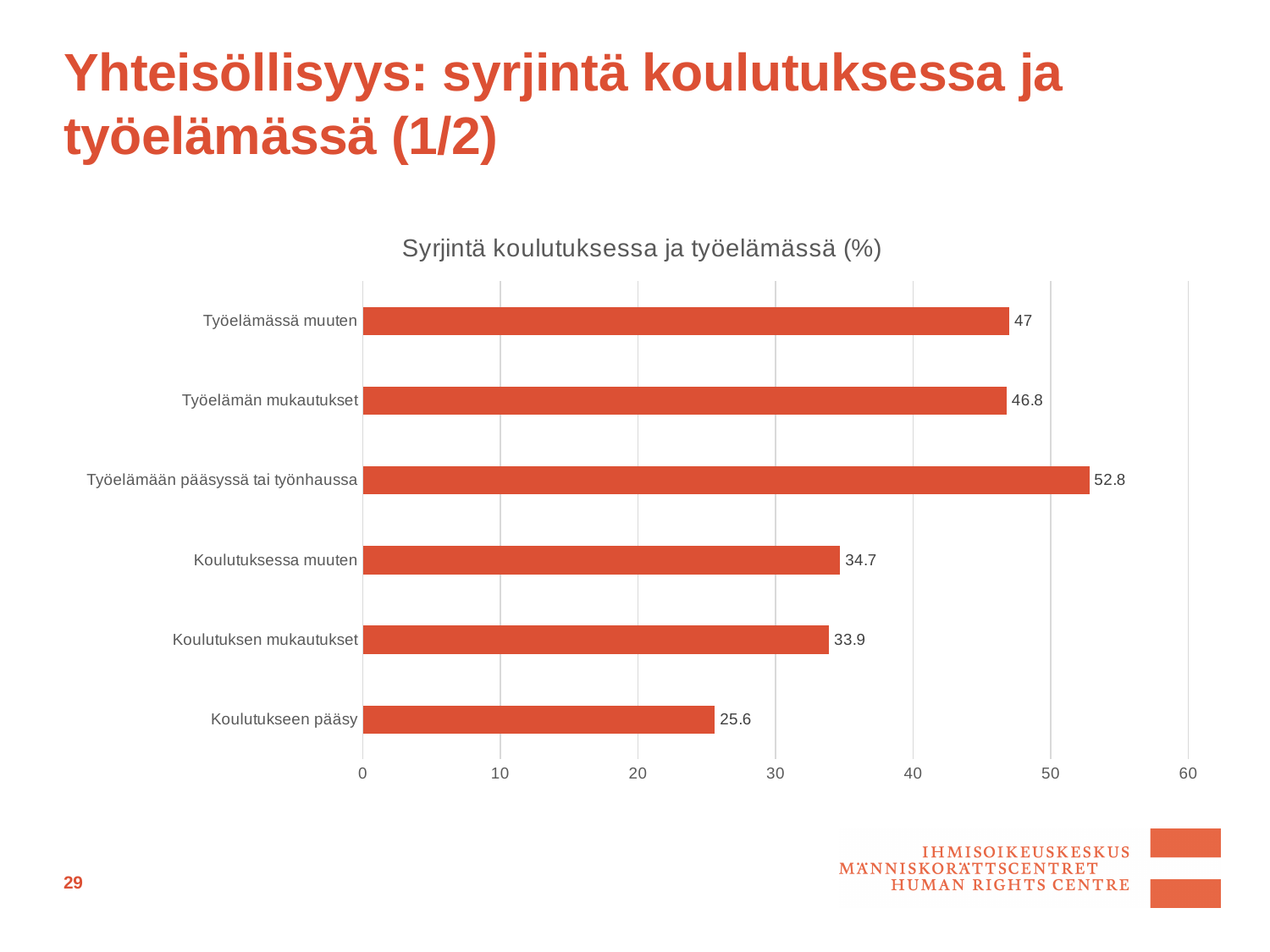
What is the value for Koulutuksen mukautukset? 33.9 What is the value for Koulutukseen pääsy? 25.6 What kind of chart is shown on the slide? Bar chart What is the value for Työelämän mukautukset? 46.8 Is the value for Työelämässä muuten greater or less than 40? greater Which category has the highest value? Työelämään pääsyssä tai työnhaussa What is the difference between the values for Työelämään pääsyssä tai työnhaussa and Koulutukseen pääsy? 27.2 Which category has the lowest value? Koulutukseen pääsy What is the value for Työelämään pääsyssä tai työnhaussa? 52.8 Which is larger, the value for Koulutuksessa muuten or the value for Koulutuksen mukautukset? Koulutuksessa muuten How many categories are shown in the chart? 6 What is the title of the chart? Syrjintä koulutuksessa ja työelämässä (%)